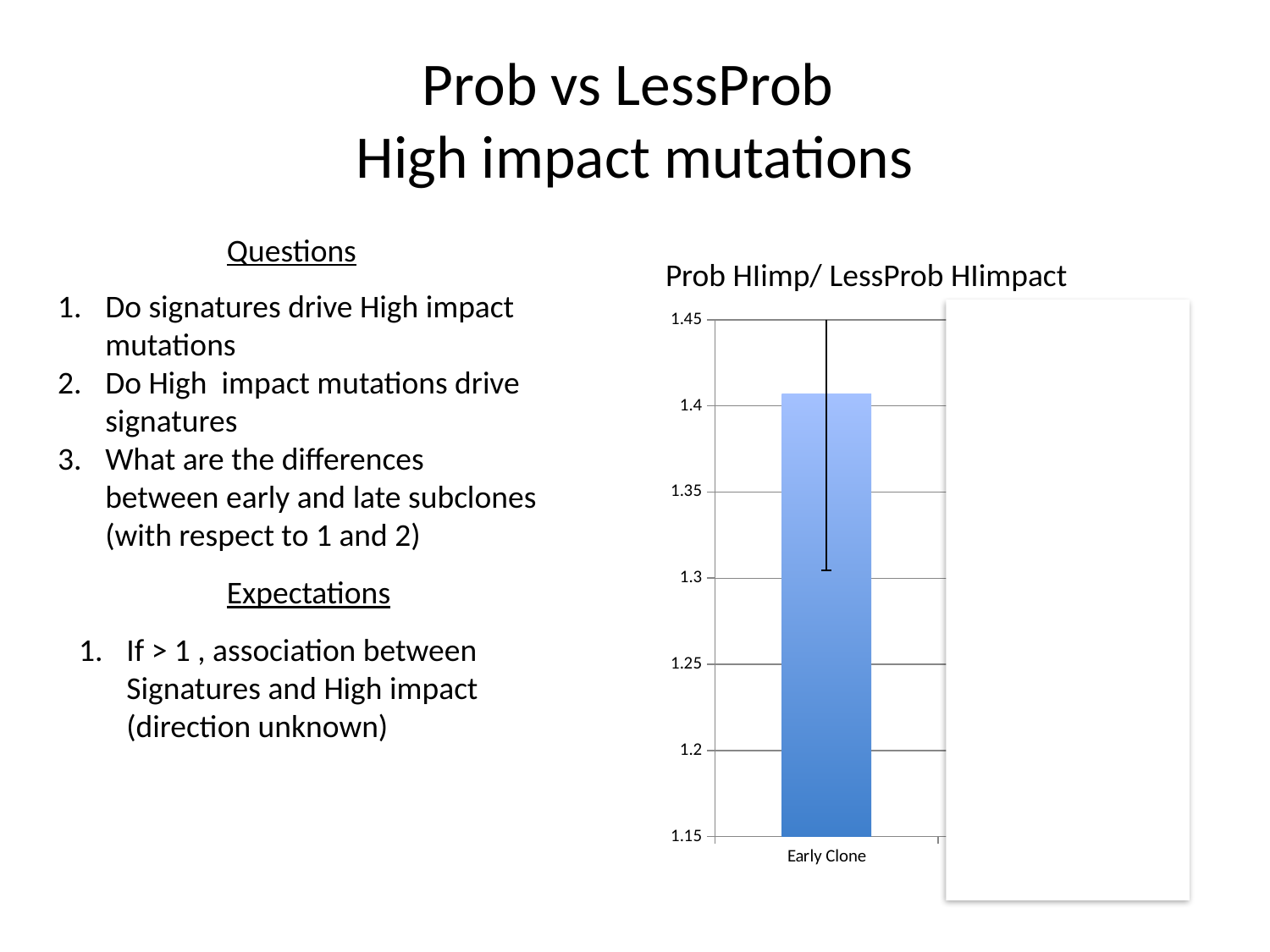
How many categories are labelled on the x axis of the chart? 1 Is the value for Early Clone greater or less than 1.3? greater What is the lowest value shown on the y axis of the chart? 1.15 Is the value for Early Clone greater or less than 1.2? greater Is the value for Early Clone greater or less than 1.45? less What is the title of the chart? Prob HIimp/ LessProb HIimpact What kind of chart is shown on the slide? bar chart What is the label of the category shown on the x axis of the chart? Early Clone